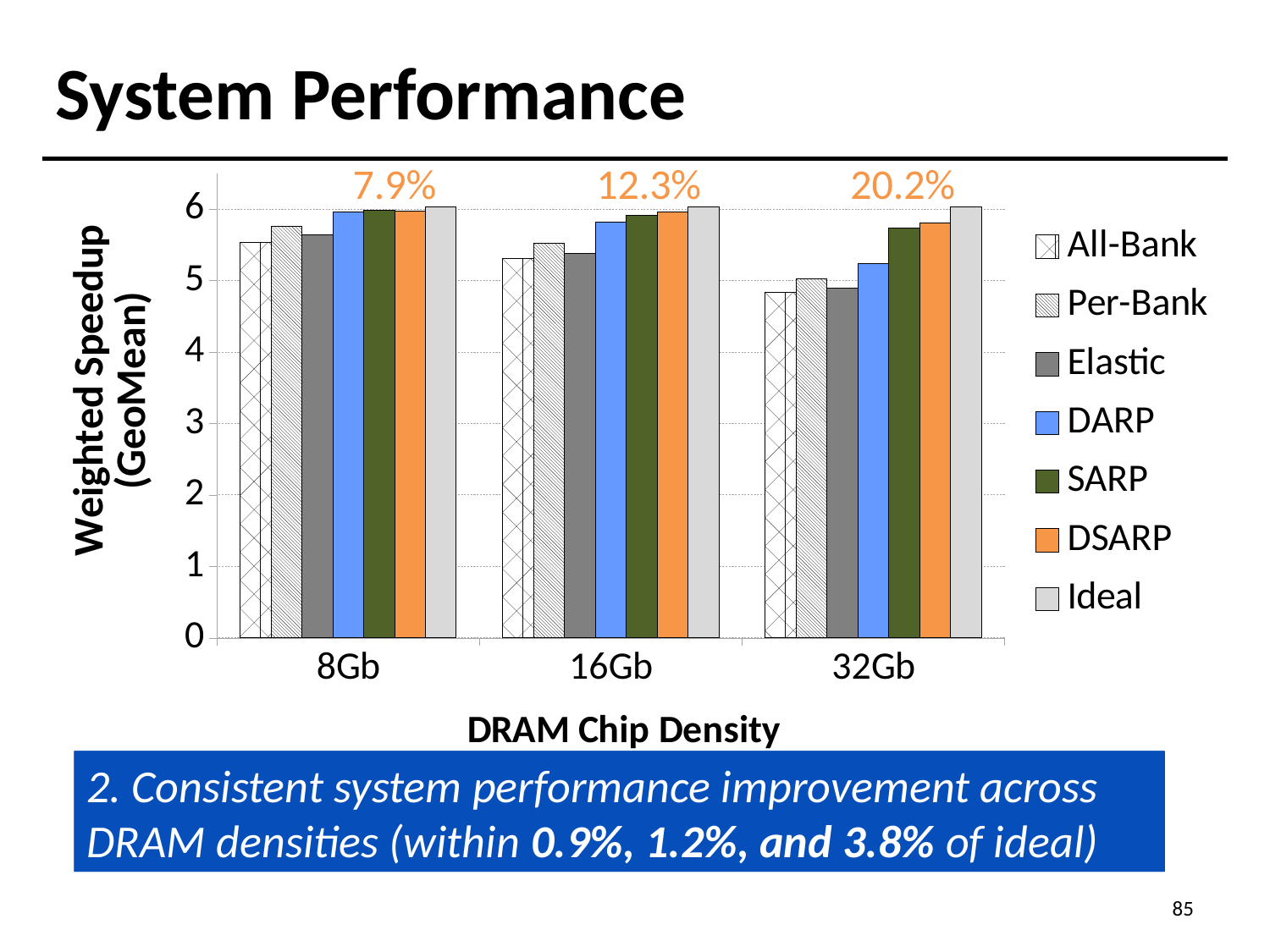
How many series does the legend list? 7 What kind of chart is shown on the slide? bar chart Is the value for All-Bank at 8Gb greater or less than 5? greater Which series has the highest value at 32Gb? Ideal At 32Gb, which is larger, DARP or Elastic? DARP What is the title of the slide containing the chart? System Performance What percentage is printed above the 32Gb group of bars? 20.2% Does the All-Bank value rise or fall as DRAM chip density increases from 8Gb to 32Gb? fall What is the label of the y axis? Weighted Speedup (GeoMean) What percentage is printed above the 8Gb group of bars? 7.9% How many DRAM chip density categories are shown on the x axis? 3 Is the value for DARP at 32Gb greater or less than 5? greater